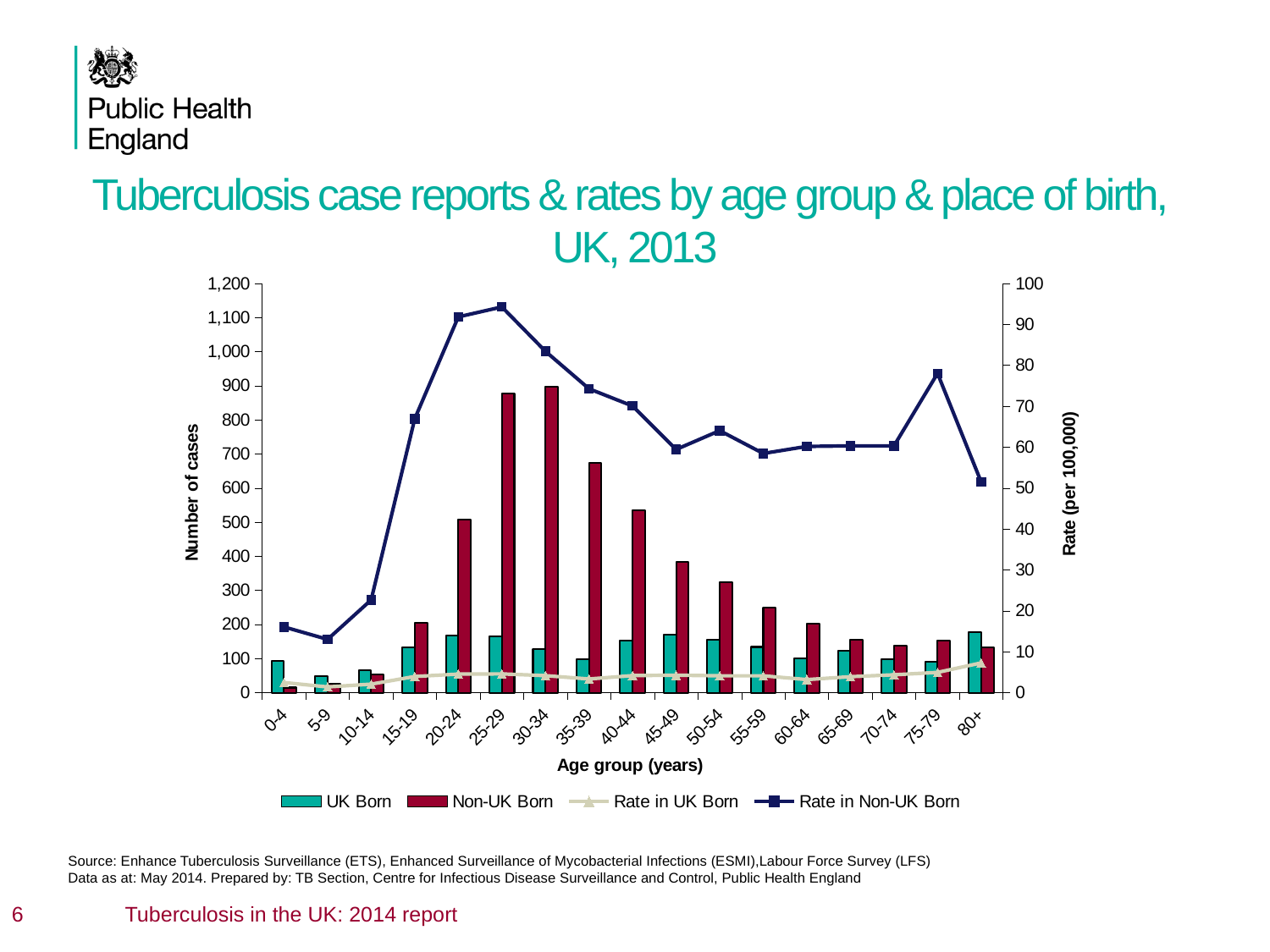
Is the Rate in Non-UK Born for the 80+ age group greater or less than 60 per 100,000? less How many age groups are shown on the x axis? 17 Is the Rate in Non-UK Born for the 20-24 age group greater or less than 80 per 100,000? greater In the 80+ age group, which is larger: the number of UK Born cases or Non-UK Born cases? UK Born Is the number of Non-UK Born cases in the 20-24 age group greater or less than 400? greater Does the Rate in Non-UK Born rise or fall from the 25-29 age group to the 45-49 age group? fall How many series does the legend list? 4 What kind of chart is shown on the slide? A combined bar and line chart Which age group has the lowest number of UK Born cases? 5-9 In the 40-44 age group, which is larger: the number of UK Born cases or Non-UK Born cases? Non-UK Born